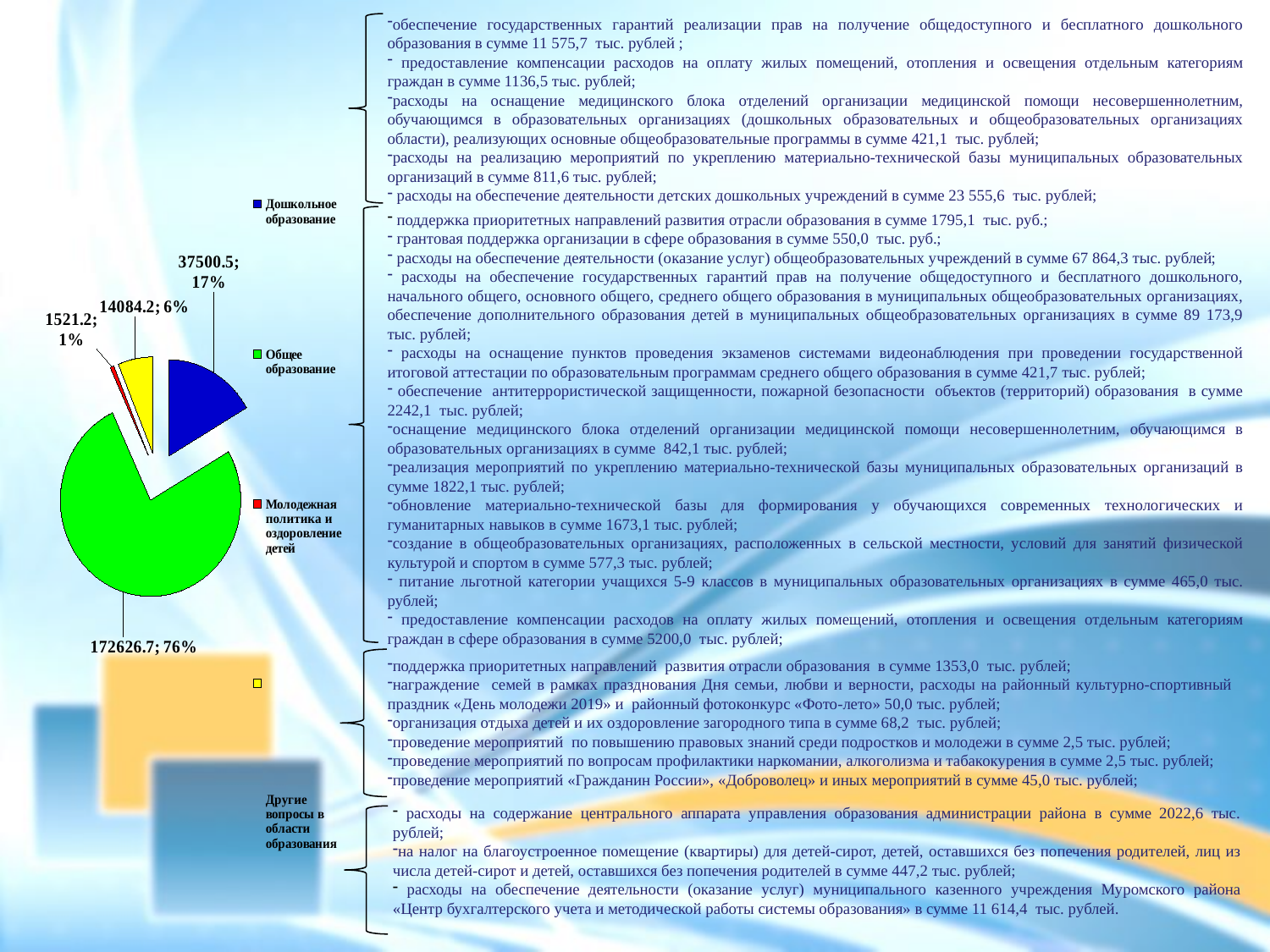
What value is shown for the slice "Дошкольное образование"? 37500.5 Which slice of the pie chart is the smallest? Молодежная политика и оздоровление детей Which slice of the pie chart is the largest? Общее образование Which colour represents "Дошкольное образование" in the pie chart? Blue What value is shown for the slice "Другие вопросы в области образования"? 14084.2 What share of the pie does "Дошкольное образование" take? 17% How many slices does the pie chart have? 4 What share of the pie does "Общее образование" take? 76% What value is shown for the slice "Общее образование"? 172626.7 What value is shown for the slice "Молодежная политика и оздоровление детей"? 1521.2 How many entries does the legend of the pie chart list? 4 What kind of chart is shown on the slide? Pie chart